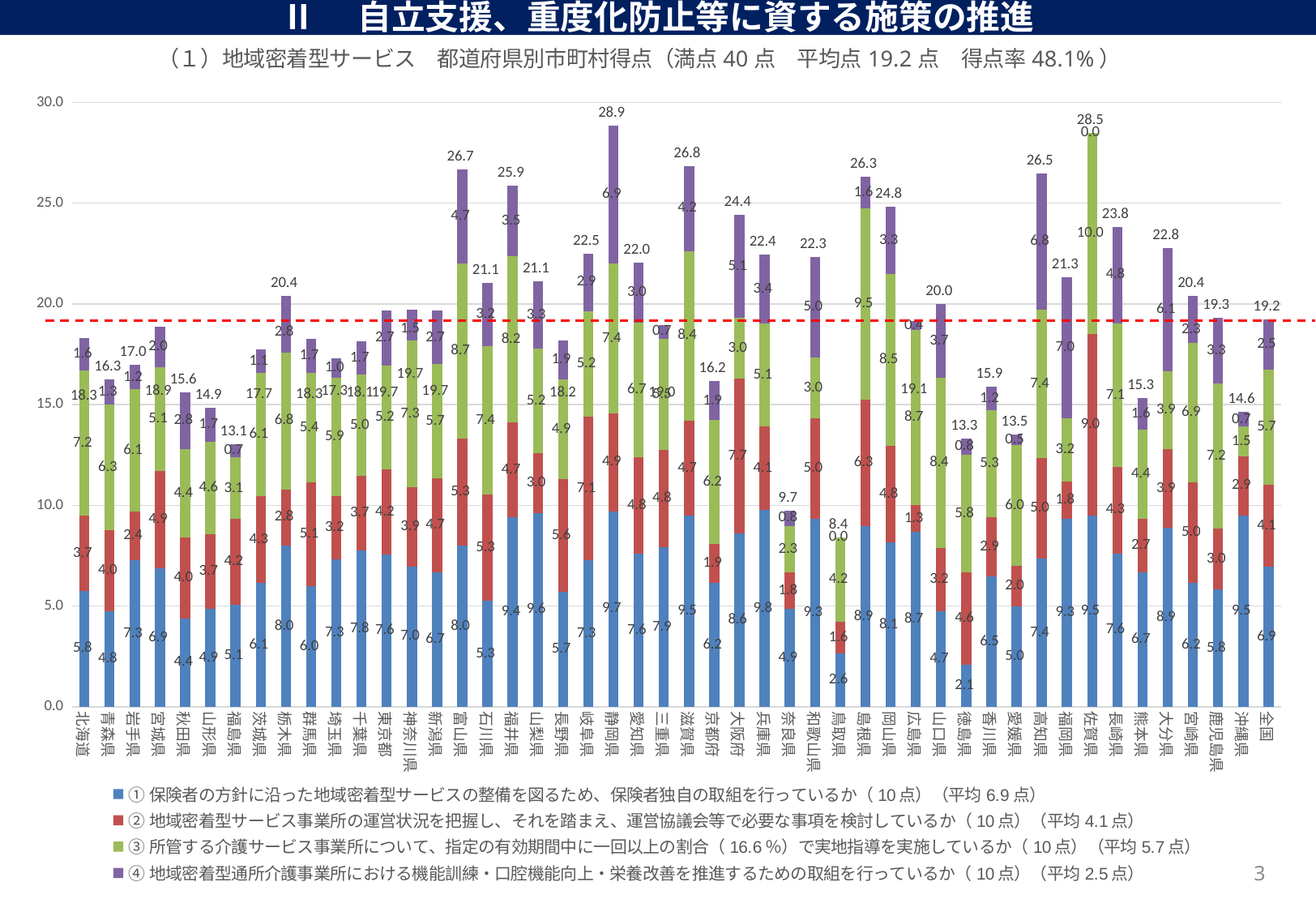
What is the value of series ③ (green) for 佐賀県? 10.0 Which has the larger total score, 島根県 or 岡山県? 島根県 Which prefecture has the highest total score? 静岡県 What is the difference between the total scores of 静岡県 (28.9) and 佐賀県 (28.5)? 0.4 How many series does the legend list? 4 What is the total score for 静岡県? 28.9 What kind of chart is shown on the slide? Stacked bar chart What is the value of series ① (blue) for 全国? 6.9 Which prefecture has the lowest total score? 鳥取県 What is the value of series ④ (purple) for 鹿児島県? 3.3 What is the total of the stacked bar for 鳥取県 (2.6 + 1.6 + 4.2 + 0.0)? 8.4 Is the total score for 鳥取県 greater or less than 10.0? less